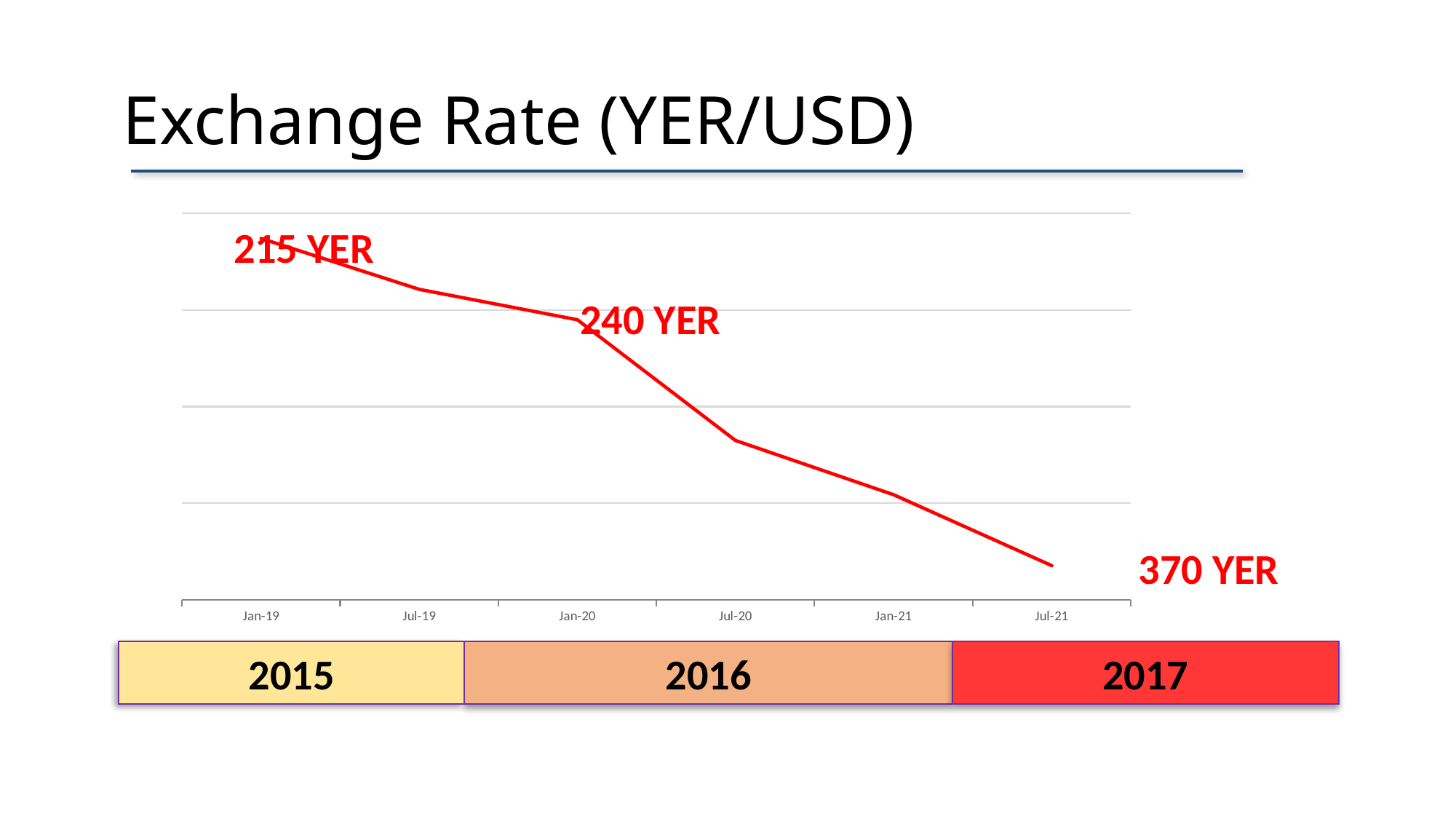
Which of the labelled values on the chart is the highest? 370 YER What value is labelled on the line at Jan-20? 240 YER What value is labelled at the end of the line, at Jul-21? 370 YER Which of the labelled values on the chart is the lowest? 215 YER What value is labelled at the start of the line, at Jan-19? 215 YER What is the title of the chart on the slide? Exchange Rate (YER/USD) Which labelled value is larger, the one at Jan-20 or the one at Jul-21? Jul-21 What is the difference between the labelled values at Jan-20 and Jan-19? 25 YER What kind of chart is shown on the slide? line chart What is the difference between the labelled values at Jul-21 and Jan-19? 155 YER How many date labels are shown on the x axis of the chart? 6 Do the labelled values increase or decrease from Jan-19 to Jul-21? increase